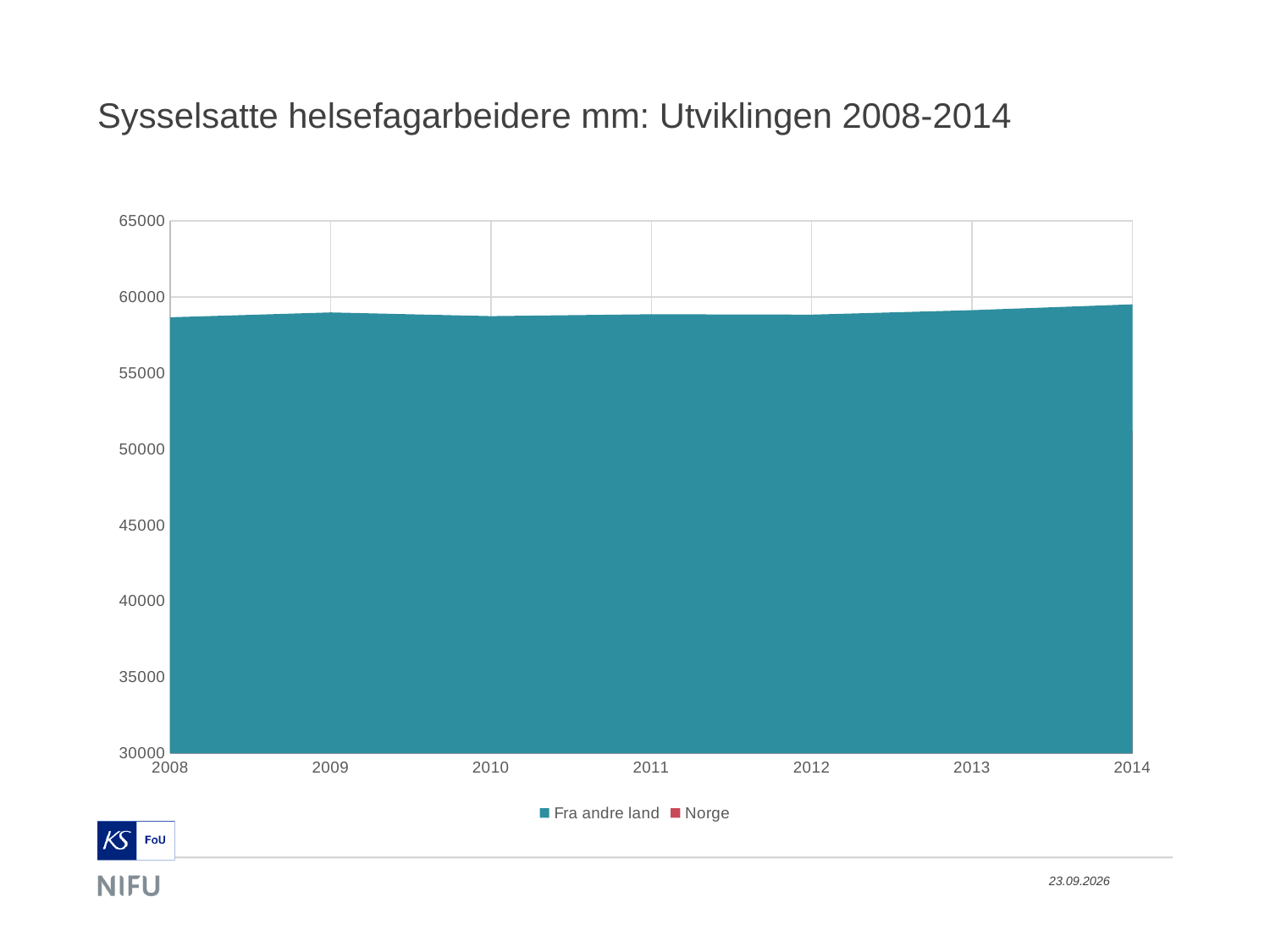
Is the top of the plotted area in 2014 greater or less than 55000? greater Is the top of the plotted area in 2011 greater or less than 50000? greater What are the two series named in the legend? Fra andre land and Norge How many series does the legend list? 2 Does the top of the plotted area rise or fall from 2012 to 2014? rise What is the last year shown on the x axis? 2014 Is the top of the plotted area in 2008 greater or less than 60000? less What is the first year shown on the x axis? 2008 What is the lowest value shown on the y axis? 30000 How many years are shown along the x axis? 7 What is the title of the slide containing the chart? Sysselsatte helsefagarbeidere mm: Utviklingen 2008-2014 What kind of chart is shown on the slide? Area chart